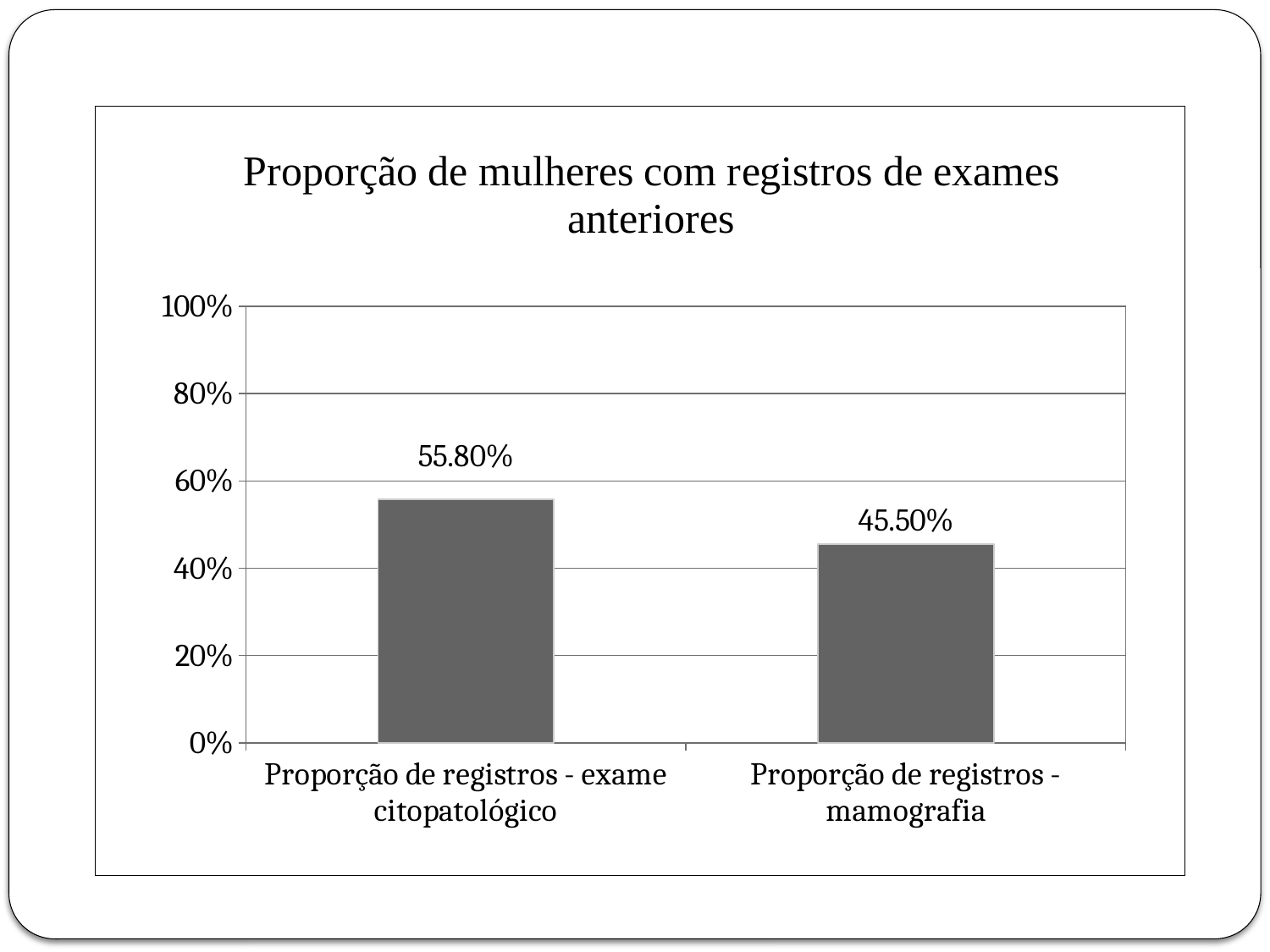
Which is larger: the value for exame citopatológico or the value for mamografia? Proporção de registros - exame citopatológico Is the value for 'Proporção de registros - exame citopatológico' greater or less than 40%? greater What is the maximum value shown on the y axis? 100% What is the difference between the value for exame citopatológico and the value for mamografia? 10.30% Is the value for 'Proporção de registros - mamografia' greater or less than 60%? less What is the title of the chart? Proporção de mulheres com registros de exames anteriores What is the value for 'Proporção de registros - mamografia'? 45.50% What kind of chart is shown on the slide? bar chart What is the value for 'Proporção de registros - exame citopatológico'? 55.80% Which category has the lowest value? Proporção de registros - mamografia How many categories are shown on the x axis? 2 Which category has the highest value? Proporção de registros - exame citopatológico